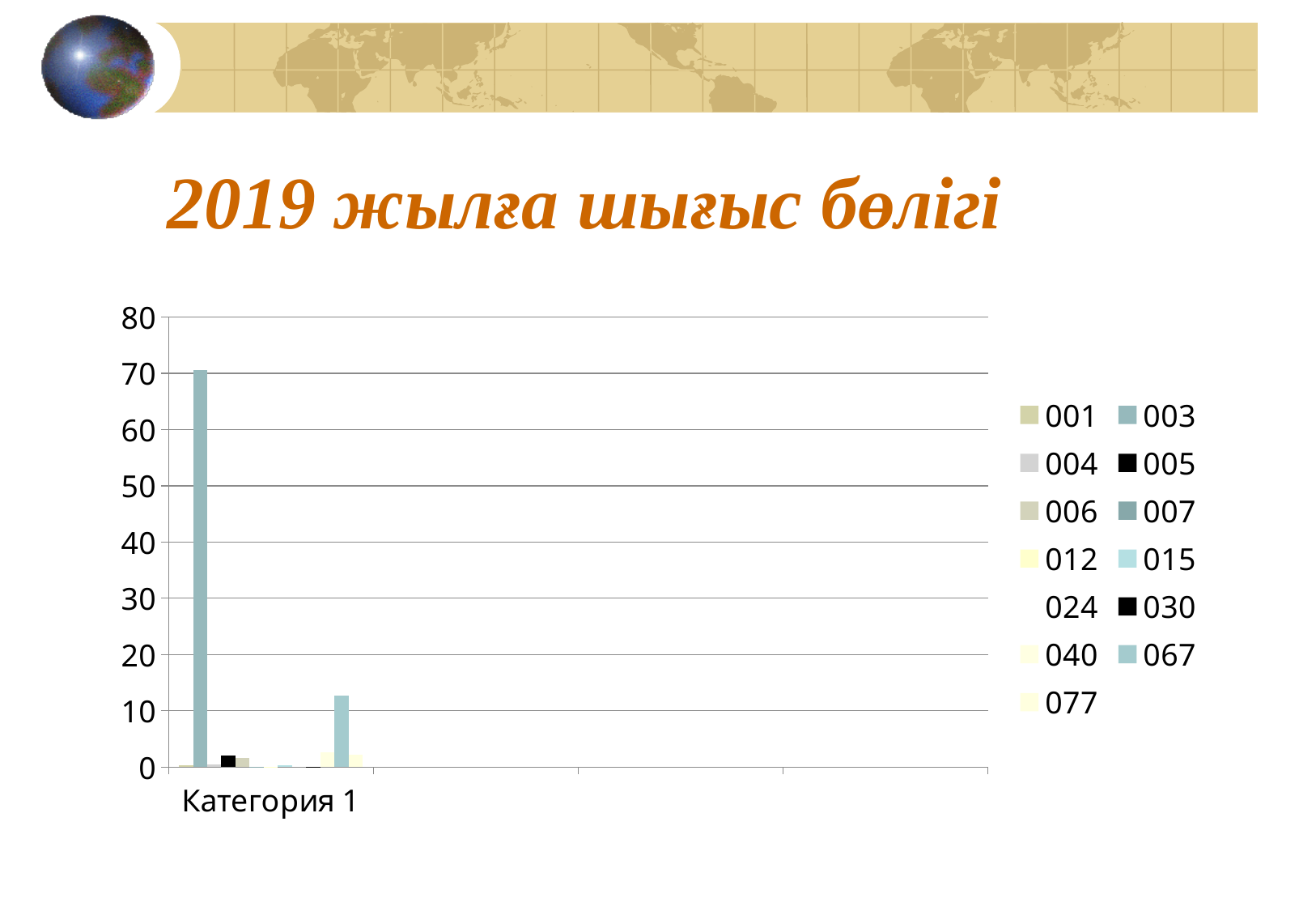
What is the title of the slide containing the chart? 2019 жылға шығыс бөлігі Is the value for series 005 greater or less than 10? less Is the value for series 067 greater or less than 20? less What is the label of the category on the x axis? Категория 1 How many categories are shown on the x axis? 1 Is the value for series 003 greater or less than 80? less How many series does the legend list? 13 What kind of chart is shown on the slide? bar chart Which is larger, the value for series 003 or the value for series 067? 003 Which series has the tallest bar in Категория 1? 003